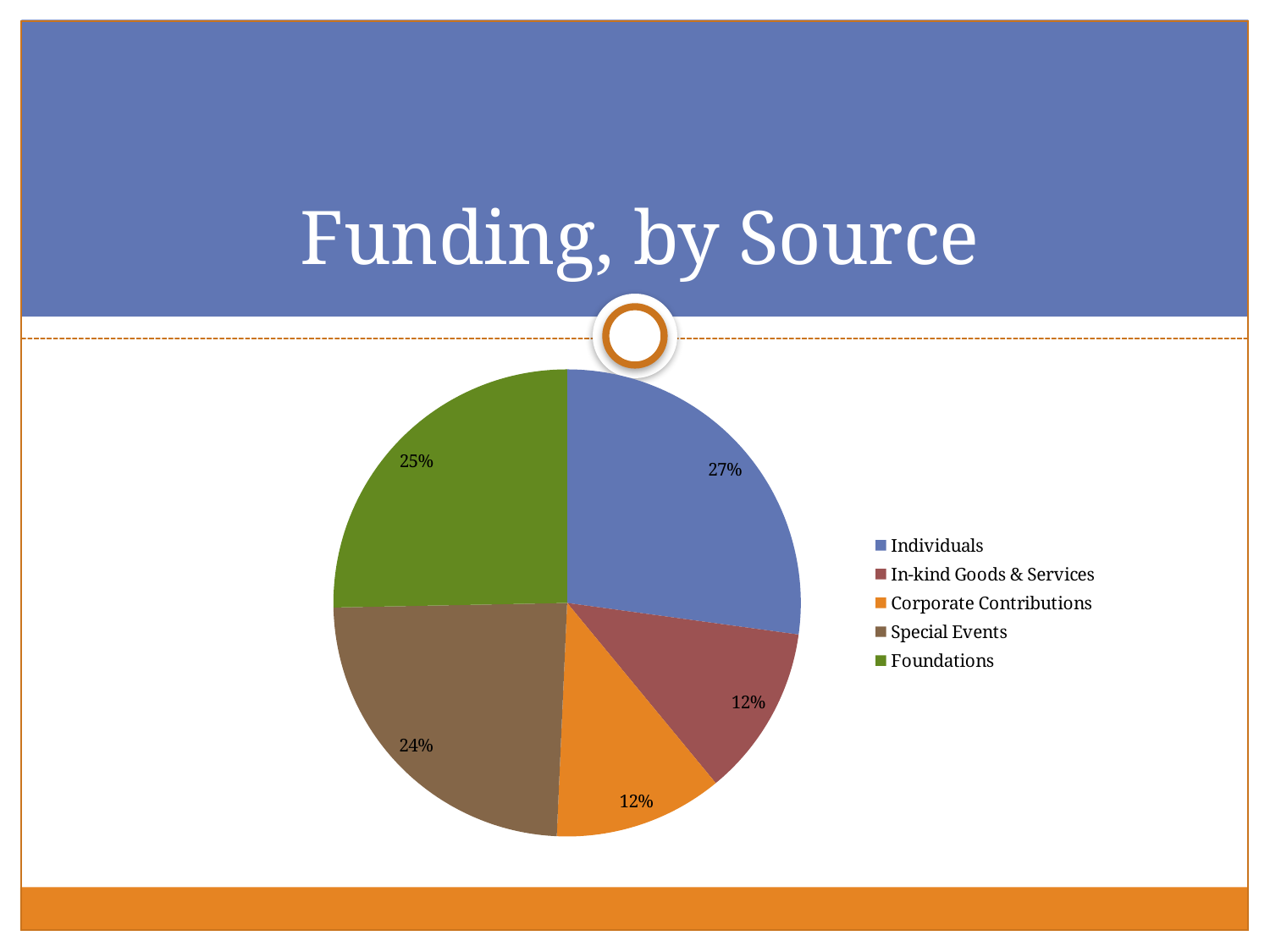
What share of funding comes from Corporate Contributions? 12% Which has a larger share, Foundations or In-kind Goods & Services? Foundations What is the difference in share between Individuals and Special Events? 3% What share of funding comes from Foundations? 25% What type of chart is shown on the slide? Pie chart What is the difference in share between Foundations and Corporate Contributions? 13% What share of funding comes from In-kind Goods & Services? 12% What share of funding comes from Special Events? 24% How many funding sources are shown in the pie chart? 5 What is the title of the slide? Funding, by Source What share of funding comes from Individuals? 27% Which funding source has the largest share? Individuals